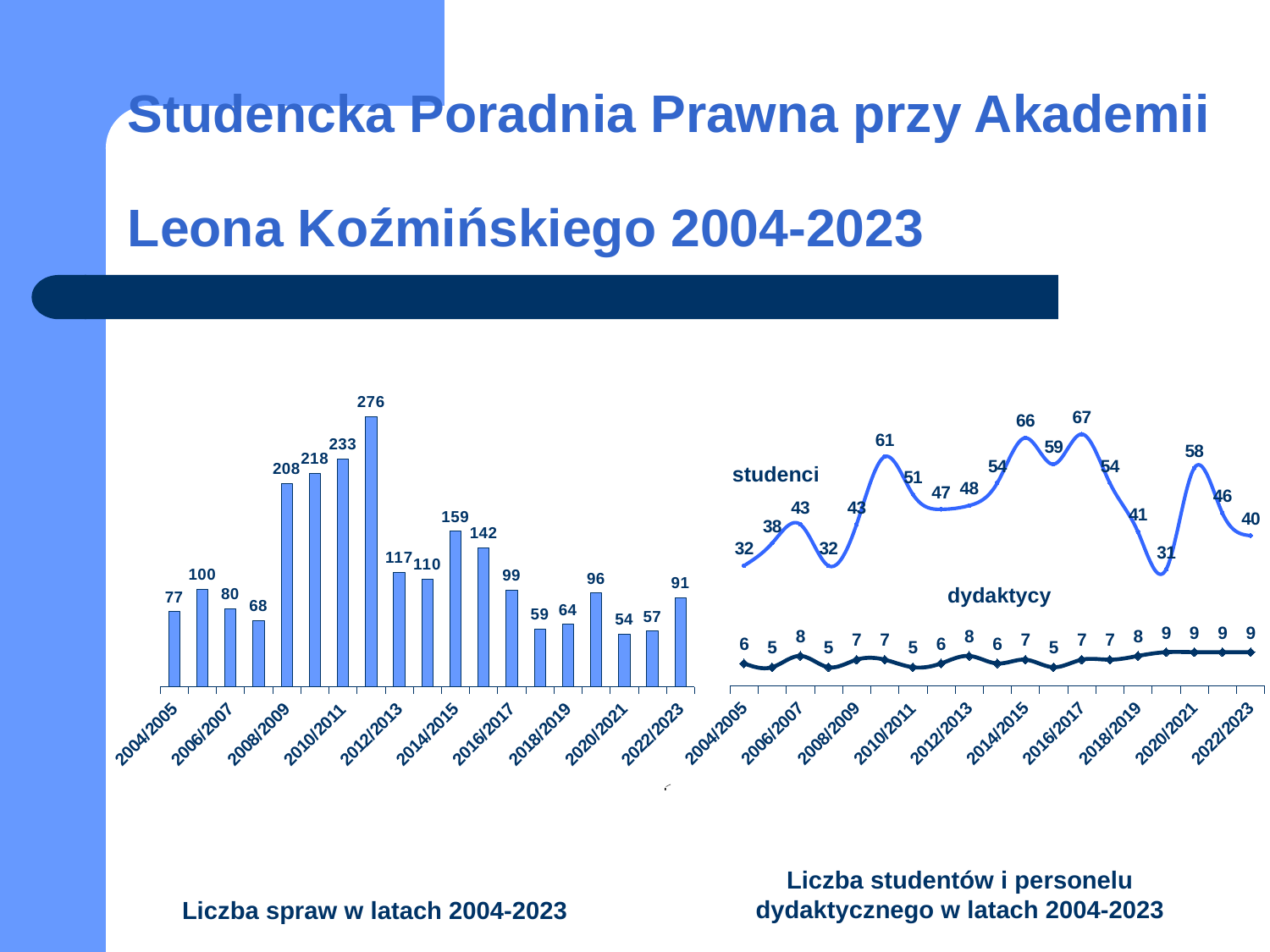
What kind of chart is 'Liczba spraw w latach 2004-2023'? bar chart In the chart 'Liczba spraw w latach 2004-2023', which is larger, the value for 2008/2009 or the value for 2014/2015? 2008/2009 In the chart 'Liczba spraw w latach 2004-2023', what is the value for 2010/2011? 233 In the chart 'Liczba spraw w latach 2004-2023', what is the highest value shown? 276 In the chart 'Liczba studentów i personelu dydaktycznego w latach 2004-2023', what is the value of the 'dydaktycy' series for 2022/2023? 9 In the chart 'Liczba studentów i personelu dydaktycznego w latach 2004-2023', what is the lowest value of the 'studenci' series? 31 In the chart 'Liczba spraw w latach 2004-2023', what is the difference between the values for 2022/2023 and 2020/2021? 37 In the chart 'Liczba studentów i personelu dydaktycznego w latach 2004-2023', what is the difference between the 'studenci' and 'dydaktycy' values for 2004/2005? 26 In the chart 'Liczba spraw w latach 2004-2023', what is the value for 2004/2005? 77 In the chart 'Liczba studentów i personelu dydaktycznego w latach 2004-2023', what is the value of the 'studenci' series for 2016/2017? 67 In the chart 'Liczba spraw w latach 2004-2023', what is the lowest value shown? 54 How many series are plotted in the chart 'Liczba studentów i personelu dydaktycznego w latach 2004-2023'? 2